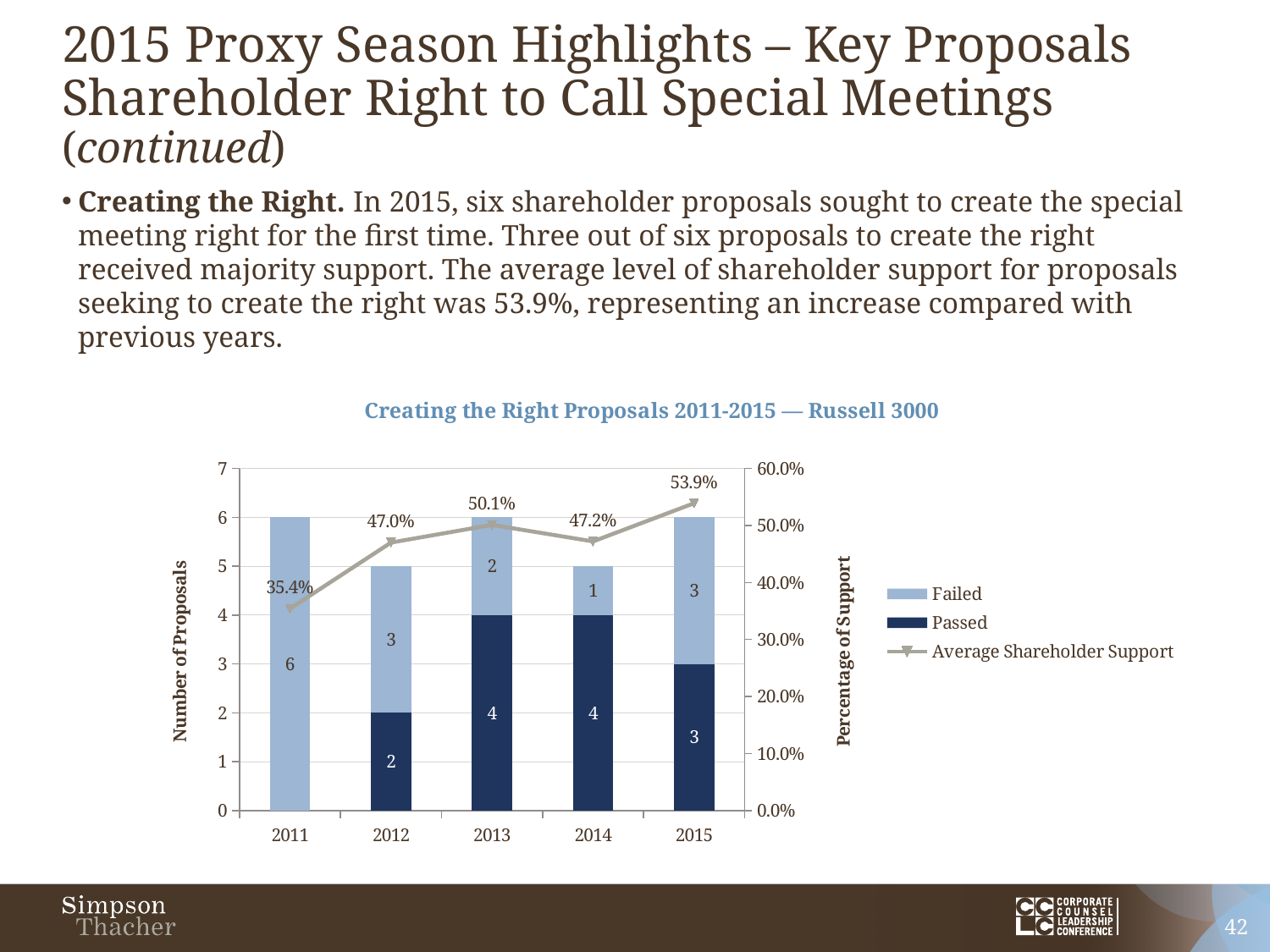
Which is larger, the number of Passed proposals in 2012 or in 2015? 2015 What is the total number of proposals (Failed plus Passed) in 2012? 5 How many series does the legend list? 3 How many Failed proposals are shown for 2014? 1 Which year has the lowest Average Shareholder Support? 2011 What is the title of the chart? Creating the Right Proposals 2011-2015 — Russell 3000 What is the difference between the Average Shareholder Support in 2015 and in 2011? 18.5% What is the Average Shareholder Support value for 2015? 53.9% How many Passed proposals are shown for 2013? 4 How many Failed proposals are shown for 2011? 6 How many years are shown on the x axis? 5 Which year has the highest Average Shareholder Support? 2015